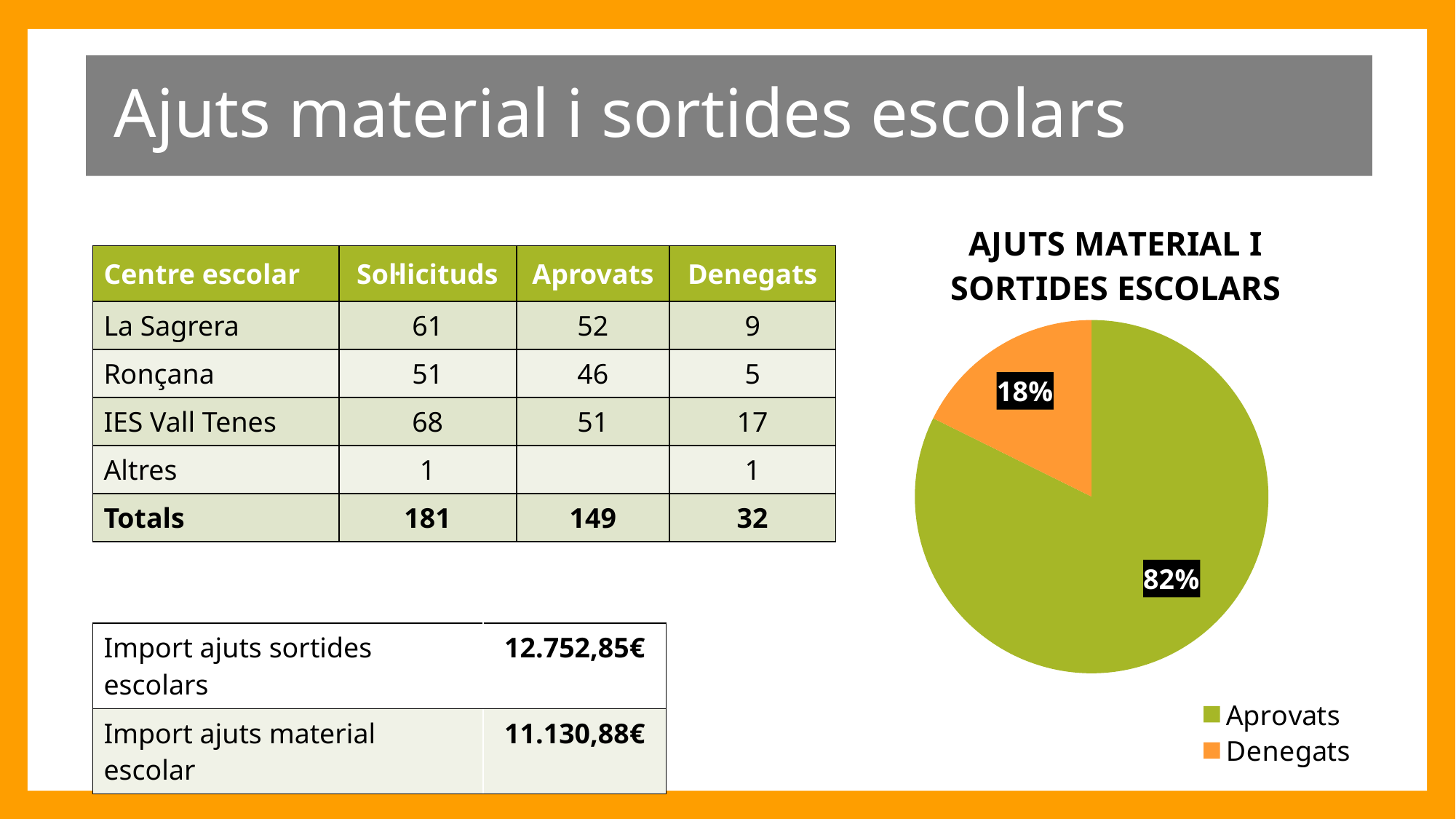
Which is larger in the pie chart, Aprovats or Denegats? Aprovats What kind of chart is shown on the slide? pie chart How many entries does the pie chart legend list? 2 What percentage of the pie chart is Denegats? 18% What colour is the Denegats slice in the pie chart? orange What is the share of the pie chart taken by the Denegats slice? 18% Which slice of the pie chart is the largest? Aprovats What percentage of the pie chart is Aprovats? 82% What is the title of the pie chart? AJUTS MATERIAL I SORTIDES ESCOLARS Which slice of the pie chart is the smallest? Denegats How many slices does the pie chart have? 2 What is the difference in percentage points between the Aprovats and Denegats slices? 64